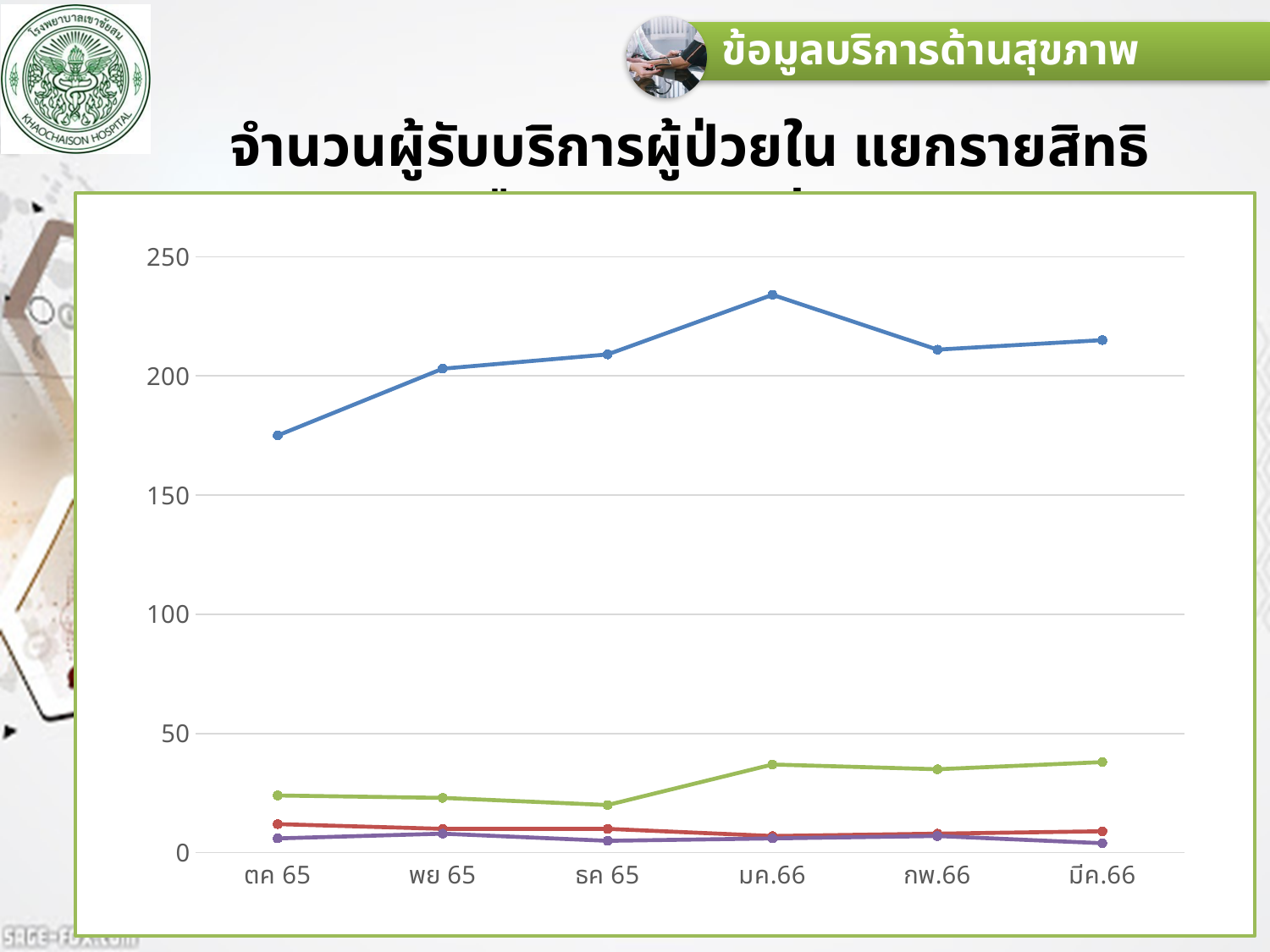
Does the blue line rise or fall from ตค 65 to มค.66? rise What kind of chart is shown on the slide? line chart For the blue line, which month has the larger value: มค.66 or กพ.66? มค.66 Is the value of the green line for มค.66 greater or less than 50? less In which month does the blue line reach its highest value? มค.66 What is the first line of the chart's title on the slide? จำนวนผู้รับบริการผู้ป่วยใน แยกรายสิทธิ How many categories (months) are shown on the x axis? 6 In which month is the blue line at its lowest value? ตค 65 Is the value of the blue line for มีค.66 greater or less than 250? less How many lines are plotted on the chart? 4 Is the value of the blue line for มค.66 greater or less than 200? greater